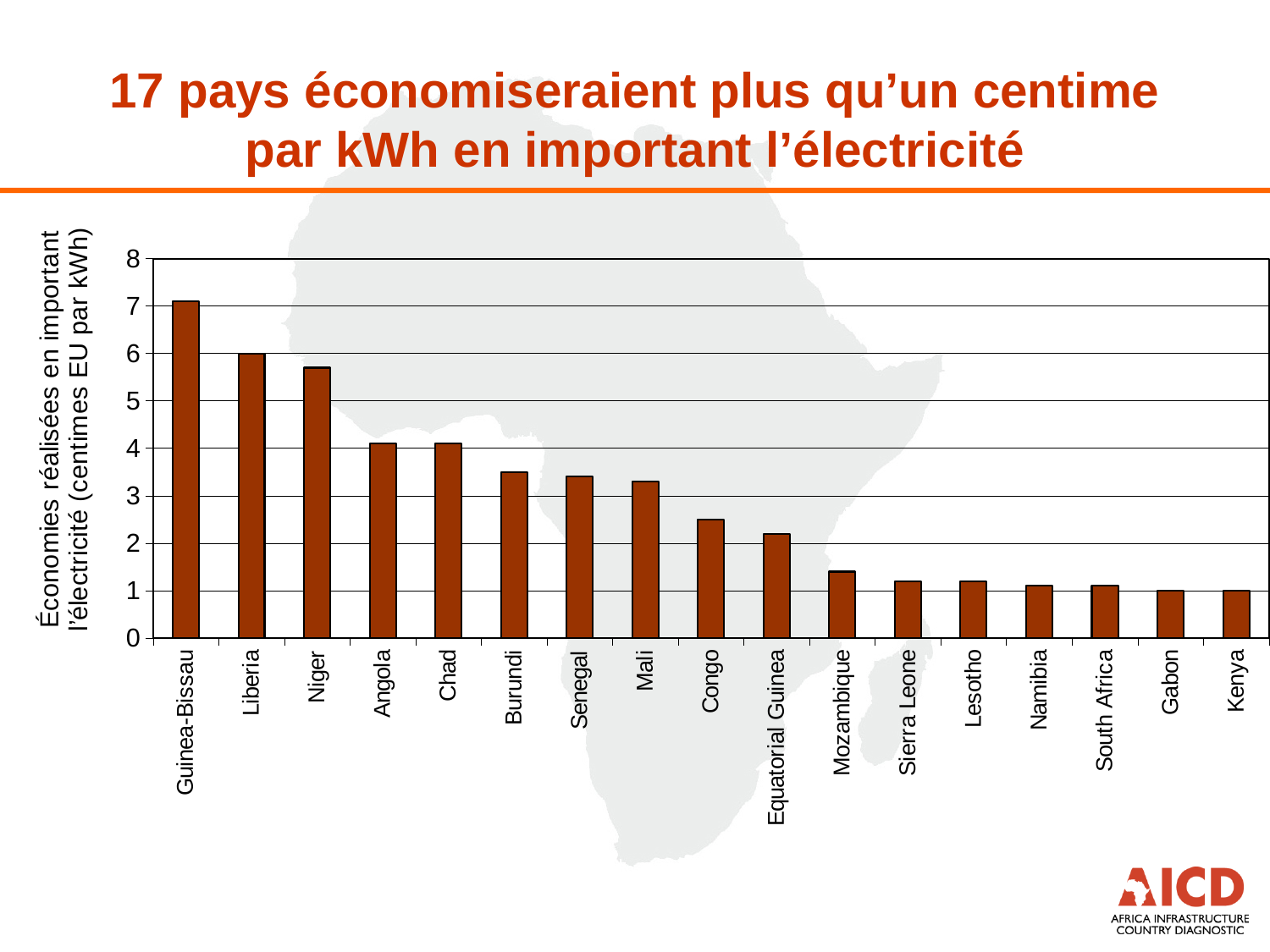
How many countries are shown on the x axis of the chart? 17 Is the value for Mozambique greater or less than 2? less Is the value for Congo greater or less than 3? less What is the label of the y axis of the chart? Économies réalisées en important l'électricité (centimes EU par kWh) What kind of chart is shown on the slide? bar chart Do the values rise or fall from left to right along the x axis? fall Which is larger, the value for Liberia or the value for Mali? Liberia Is the value for Niger greater or less than 5? greater Which country has the highest savings value in the chart? Guinea-Bissau